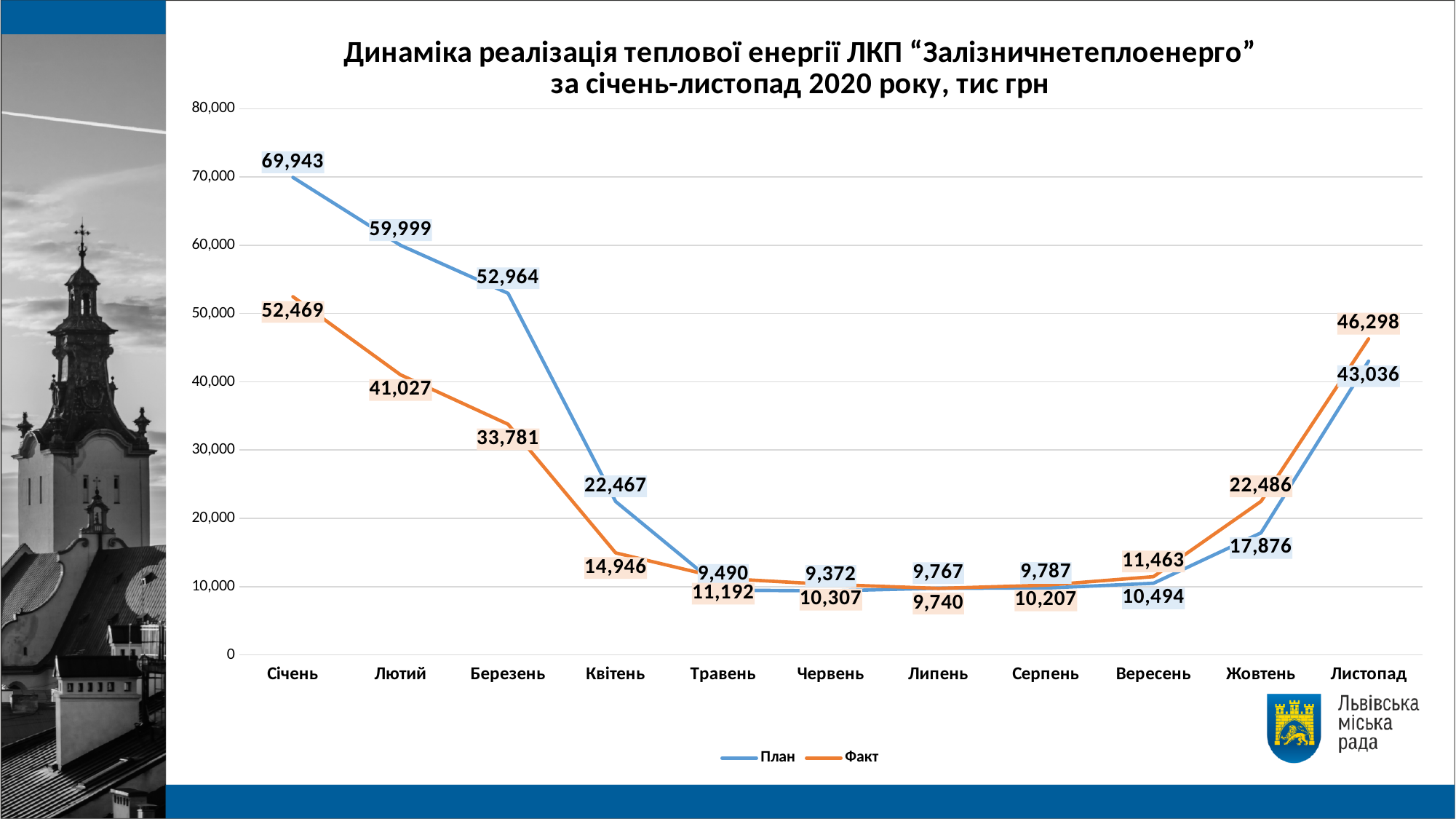
What is the difference between the План and Факт values for Січень? 17,474 In which month is the План series highest? Січень In which month is the Факт series lowest? Липень How many series does the legend list? 2 What is the План value for Жовтень? 17,876 Does the План series rise or fall from Січень to Квітень? Fall What is the План value for Січень? 69,943 How many months are plotted on the x axis? 11 What kind of chart is shown on the slide? Line chart What is the Факт value for Листопад? 46,298 What is the Факт value for Березень? 33,781 Which is larger for Жовтень, the План value or the Факт value? Факт